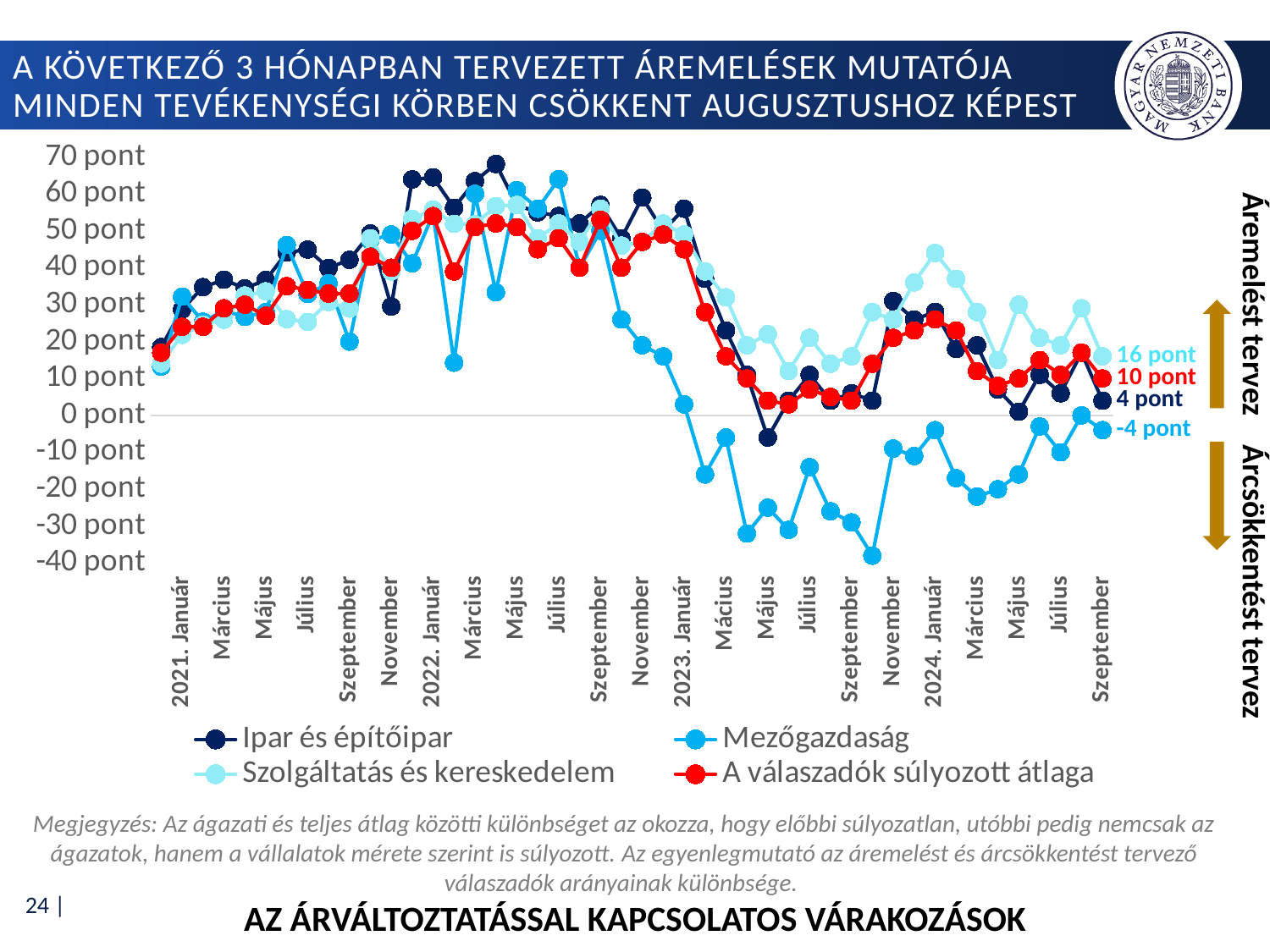
What is the final (2024 Szeptember) value for A válaszadók súlyozott átlaga? 10 pont How many series does the legend list? 4 What is the final (2024 Szeptember) value for Szolgáltatás és kereskedelem? 16 pont Is the value for A válaszadók súlyozott átlaga in 2021 Január greater or less than 30 pont? less Which series has the lowest value at the last point (2024 Szeptember)? Mezőgazdaság What is the final (2024 Szeptember) value for Mezőgazdaság? -4 pont What is the difference between the final values of Szolgáltatás és kereskedelem and Mezőgazdaság? 20 pont At the last point, which is larger: the value for A válaszadók súlyozott átlaga or for Ipar és építőipar? A válaszadók súlyozott átlaga Which series is drawn in red? A válaszadók súlyozott átlaga Which series has the highest value at the last point (2024 Szeptember)? Szolgáltatás és kereskedelem What kind of chart is shown on the slide? line chart What is the final (2024 Szeptember) value for Ipar és építőipar? 4 pont